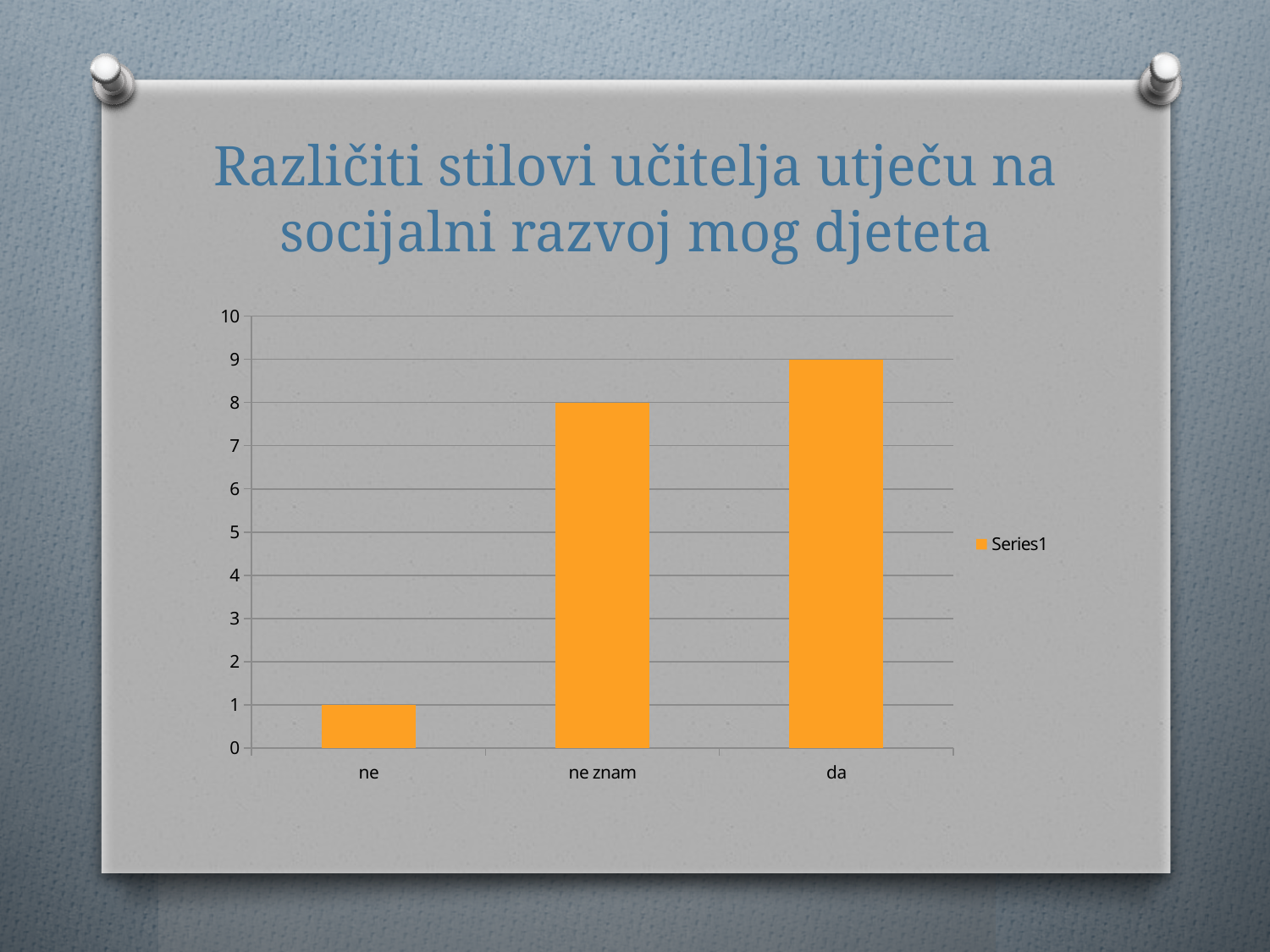
What is the difference between the values for "da" and "ne"? 8 What is the name of the series shown in the chart legend? Series1 What is the value for the category "ne znam"? 8 What is the value for the category "ne"? 1 What type of chart is shown on the slide? bar chart Which is larger, the value for "ne znam" or the value for "ne"? ne znam Is the value for "ne znam" greater or less than 5? greater Which category has the lowest value? ne How many series does the chart legend list? 1 How many categories are shown on the x axis of the chart? 3 Which category has the highest value? da What is the value for the category "da"? 9